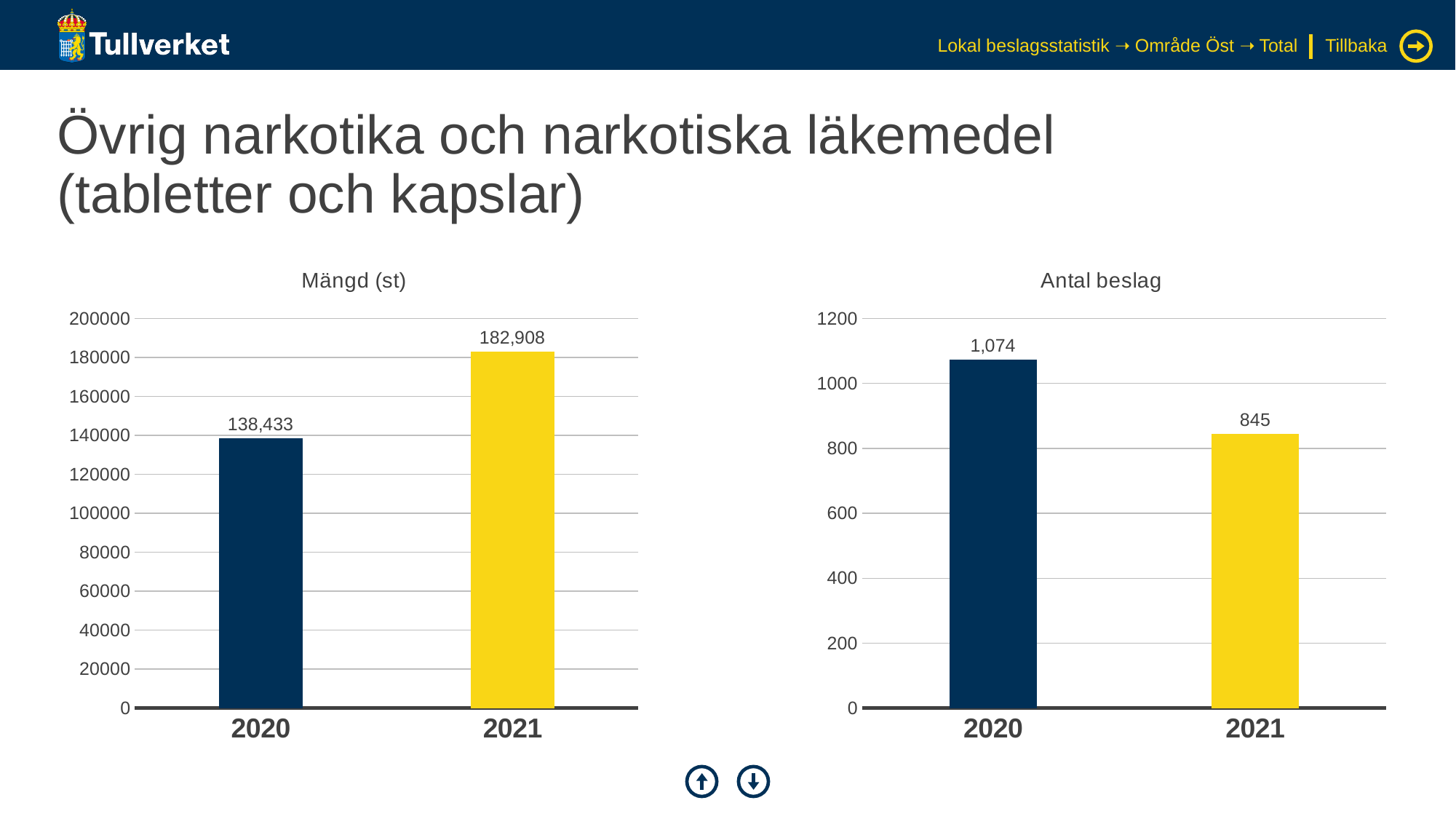
What kind of chart is the 'Antal beslag' chart? bar chart In the 'Antal beslag' chart, which year has the lower value? 2021 In the 'Mängd (st)' chart, which year has the higher value? 2021 In the 'Antal beslag' chart, what is the value for 2021? 845 In the 'Mängd (st)' chart, what is the difference between the 2021 and 2020 values? 44,475 How many categories are shown on the x axis of the 'Mängd (st)' chart? 2 In the 'Mängd (st)' chart, what is the value for 2020? 138,433 In the 'Antal beslag' chart, is the value for 2020 greater or less than 1000? greater In the 'Mängd (st)' chart, do the values rise or fall from 2020 to 2021? rise In the 'Mängd (st)' chart, what is the value for 2021? 182,908 In the 'Antal beslag' chart, what is the value for 2020? 1,074 In the 'Antal beslag' chart, what is the difference between the 2020 and 2021 values? 229